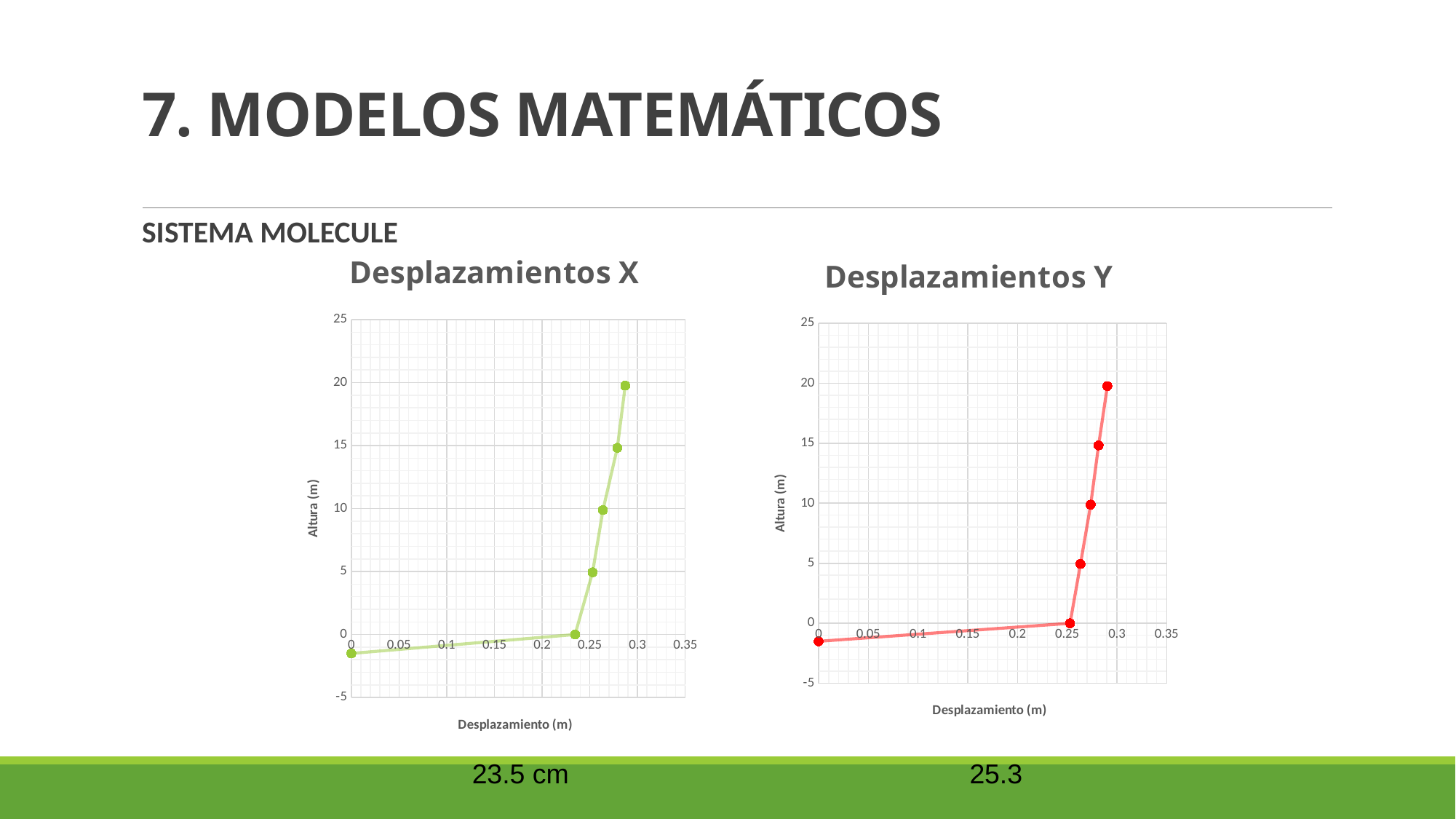
What colour is the line in the "Desplazamientos Y" chart? red How many data points are plotted in the "Desplazamientos X" chart? 6 What kind of chart is the "Desplazamientos X" chart? line chart In the "Desplazamientos Y" chart, does altura rise or fall as desplazamiento increases? rise How many data points are plotted in the "Desplazamientos Y" chart? 6 What is the title of the horizontal axis in the "Desplazamientos X" chart? Desplazamiento (m) In the "Desplazamientos X" chart, does altura rise or fall as desplazamiento increases? rise In the "Desplazamientos X" chart, is the altura of the highest point greater or less than 15? greater In the "Desplazamientos X" chart, is the altura of the lowest point greater or less than 0? less In the "Desplazamientos Y" chart, is the desplazamiento of the topmost point greater or less than 0.25? greater